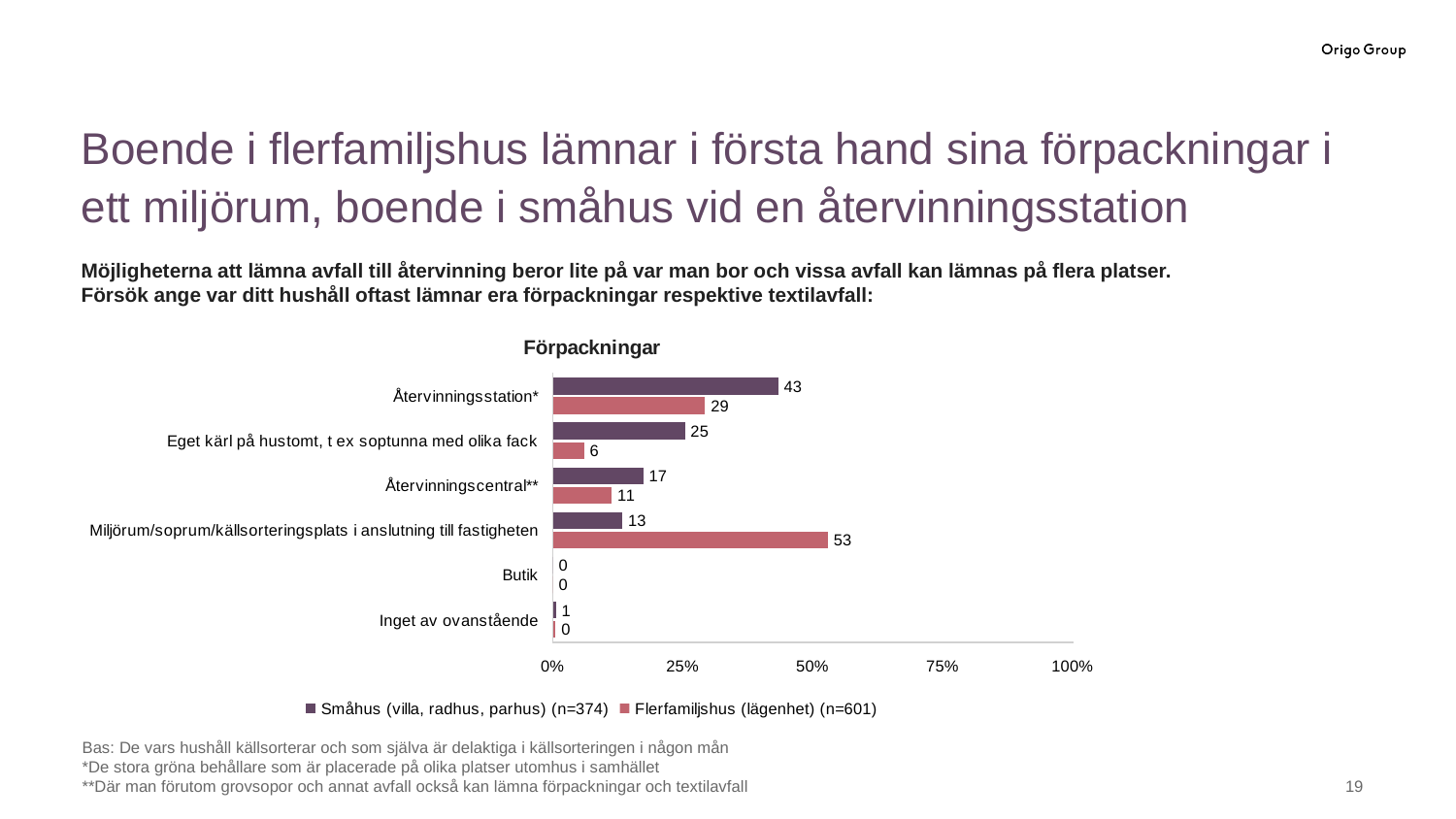
Which category has the highest value for the Flerfamiljshus (lägenhet) series? Miljörum/soprum/källsorteringsplats i anslutning till fastigheten For Återvinningscentral**, which series has the larger value, Småhus or Flerfamiljshus? Småhus (villa, radhus, parhus) (n=374) What is the value for Återvinningscentral** for the Småhus (villa, radhus, parhus) series? 17 What is the value for Eget kärl på hustomt, t ex soptunna med olika fack for the Flerfamiljshus (lägenhet) series? 6 What is the difference between the Flerfamiljshus and Småhus values for Miljörum/soprum/källsorteringsplats i anslutning till fastigheten? 40 What is the difference between the Småhus and Flerfamiljshus values for Återvinningsstation*? 14 How many categories are shown on the y axis of the chart? 6 Which category has the highest value for the Småhus (villa, radhus, parhus) series? Återvinningsstation* What is the value for Återvinningsstation* for the Småhus (villa, radhus, parhus) series? 43 How many series does the legend list? 2 What kind of chart is shown on the slide? Bar chart What is the value for Miljörum/soprum/källsorteringsplats i anslutning till fastigheten for the Flerfamiljshus (lägenhet) series? 53